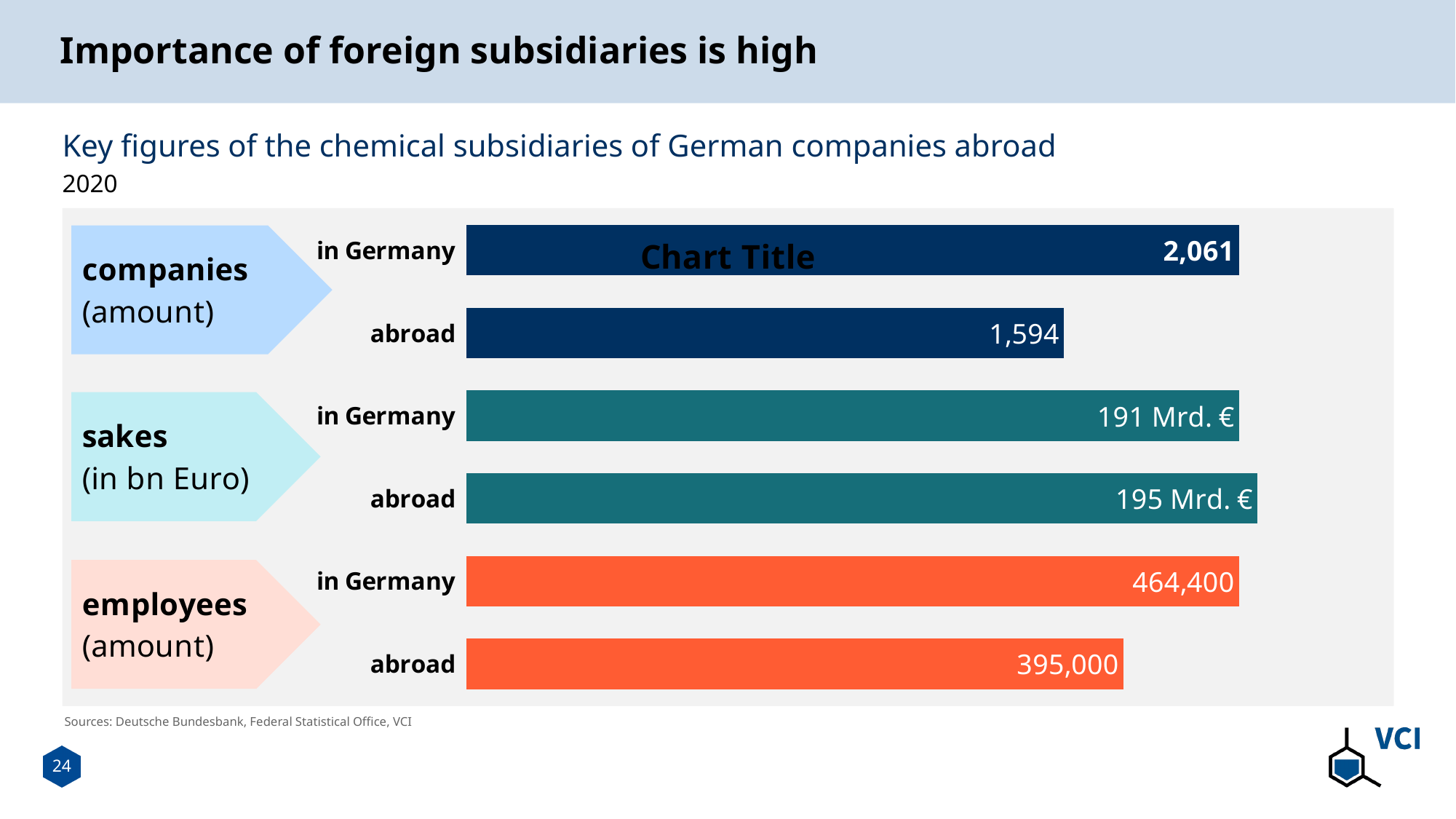
What kind of chart is shown on the slide? bar chart How many chemical companies are shown for 'in Germany' in the companies (amount) group? 2,061 How many more companies are there in Germany than abroad? 467 What is the value for 'abroad' in the employees (amount) group? 395,000 In the sakes (in bn Euro) group, which is larger: in Germany or abroad? abroad What is the value for 'abroad' in the sakes (in bn Euro) group? 195 Mrd. € What is the value for 'abroad' in the companies (amount) group? 1,594 What is the value for 'in Germany' in the employees (amount) group? 464,400 How many bars are plotted in the chart? 6 What is the difference between employees in Germany and employees abroad? 69,400 By how much do sales abroad exceed sales in Germany? 4 Mrd. € What is the value for 'in Germany' in the sakes (in bn Euro) group? 191 Mrd. €